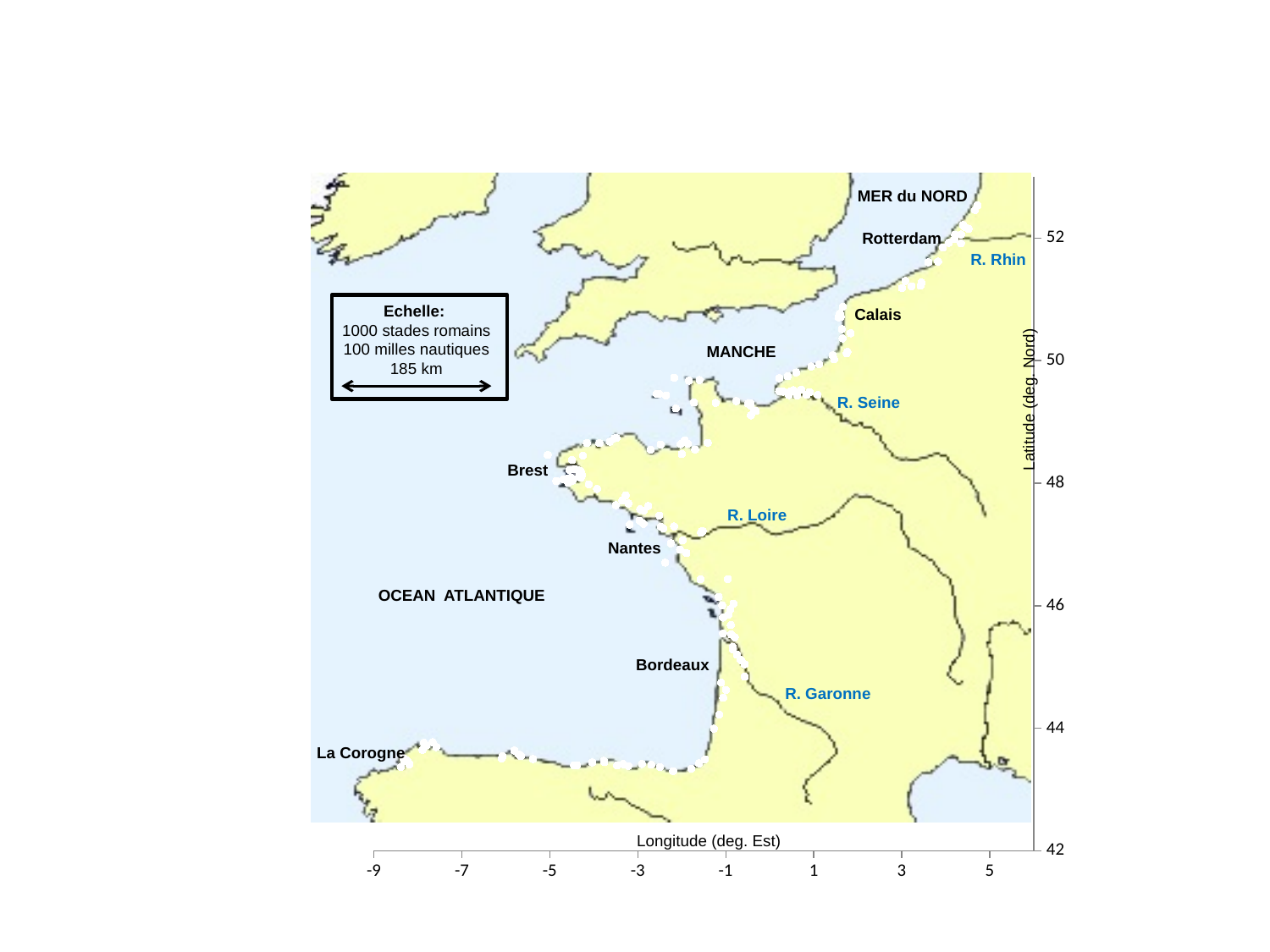
According to the scale box, how many kilometres correspond to 1000 stades romains? 185 km Is the latitude of Brest greater or less than 46? greater Which labelled city lies further north, Brest or Bordeaux? Brest What kind of chart is shown on the slide? scatter plot on a map Is the latitude of Rotterdam greater or less than 50? greater Is the longitude of La Corogne greater or less than -7? less Which labelled city lies further east, Calais or Brest? Calais What are the lowest and highest tick values on the latitude axis? 42 and 52 How many rivers are labelled on the map? 4 What are the titles of the x axis and the y axis? Longitude (deg. Est) and Latitude (deg. Nord)